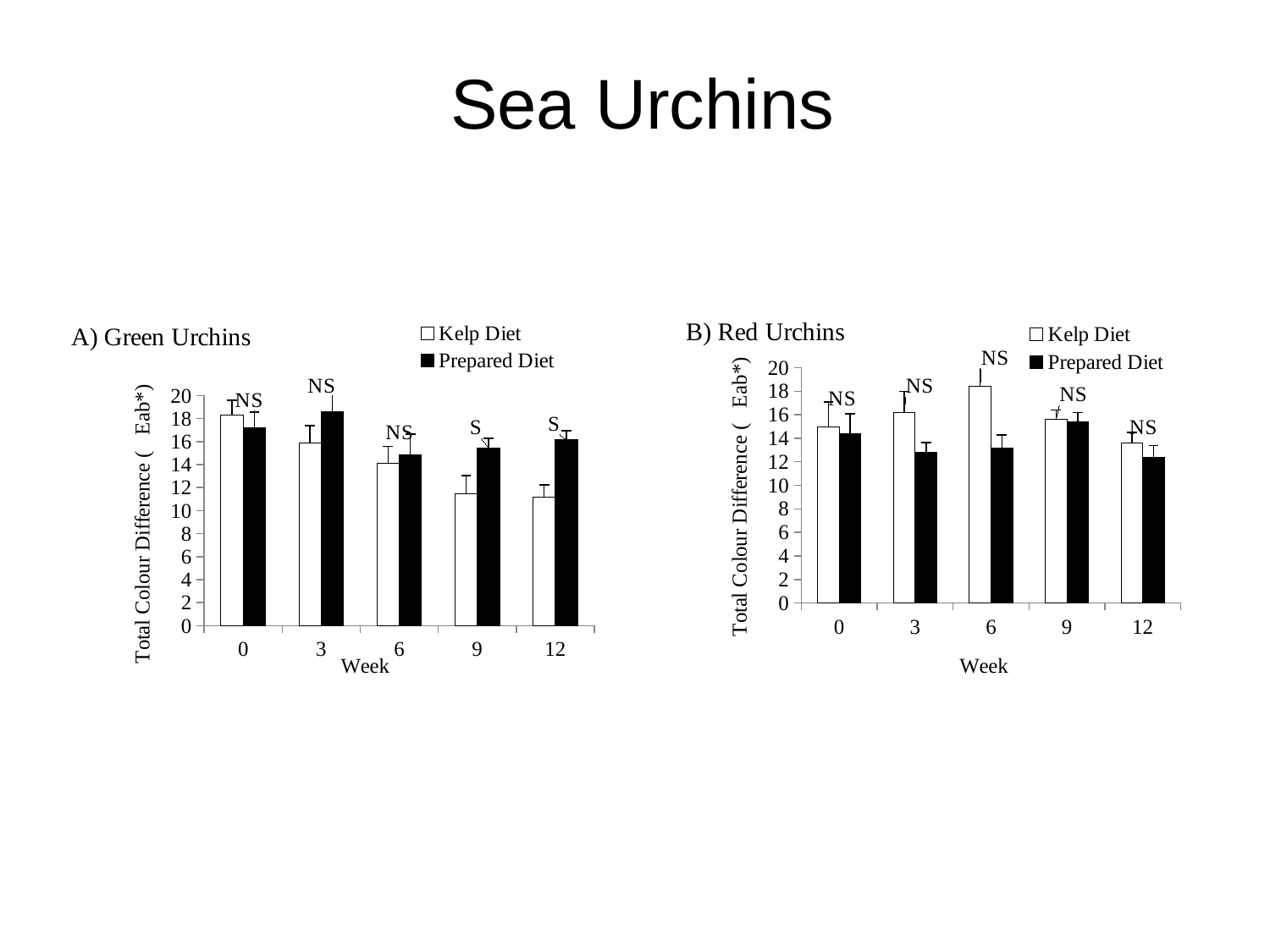
In the Green Urchins chart (A), is the Prepared Diet value at week 3 greater or less than 16? greater In the Green Urchins chart (A), is the Kelp Diet value at week 12 greater or less than 12? less In the Red Urchins chart (B), is the Kelp Diet value at week 6 greater or less than 16? greater How many series does the legend of the Green Urchins chart (A) list? 2 How many week categories are shown on the x axis of the Red Urchins chart (B)? 5 In the Red Urchins chart (B), at which week is the Kelp Diet value highest? 6 In the Green Urchins chart (A), at which week is the Kelp Diet value highest? 0 What kind of chart is the Green Urchins chart (A)? bar chart In the Green Urchins chart (A), do the Kelp Diet values rise or fall from week 0 to week 12? fall In the Green Urchins chart (A), at week 12, which is larger: the Kelp Diet or the Prepared Diet value? Prepared Diet In the Green Urchins chart (A), which weeks are marked with the annotation "S" rather than "NS"? 9 and 12